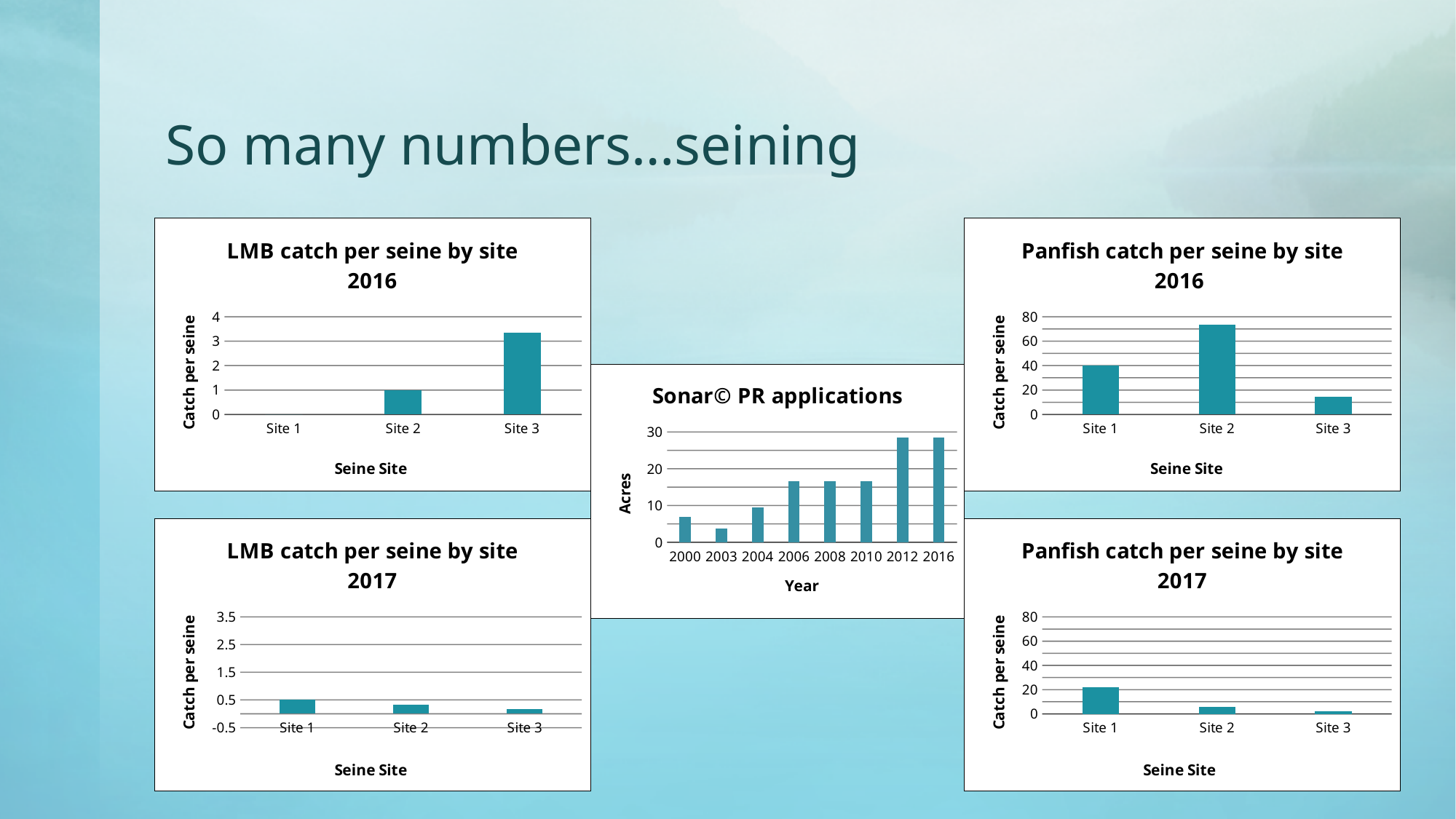
In the 'Panfish catch per seine by site 2016' chart, what is the catch per seine for Site 1? 40 In the 'Sonar© PR applications' chart, is the value for 2012 greater or less than 20? greater In the 'LMB catch per seine by site 2017' chart, is the value for Site 1 greater or less than 1.5? less In the 'Panfish catch per seine by site 2017' chart, which site has the highest catch per seine? Site 1 In the 'LMB catch per seine by site 2016' chart, which site has the highest catch per seine? Site 3 In the 'Sonar© PR applications' chart, do the acres generally rise or fall from 2000 to 2016? rise In the 'Panfish catch per seine by site 2016' chart, which site has the lowest catch per seine? Site 3 In the 'LMB catch per seine by site 2016' chart, what is the catch per seine for Site 2? 1 In the 'Sonar© PR applications' chart, which year has the lowest acres? 2003 In the 'LMB catch per seine by site 2017' chart, which site has the highest catch per seine? Site 1 In the 'Sonar© PR applications' chart, how many years are plotted? 8 In the 'LMB catch per seine by site 2016' chart, is the value for Site 3 greater or less than 3? greater